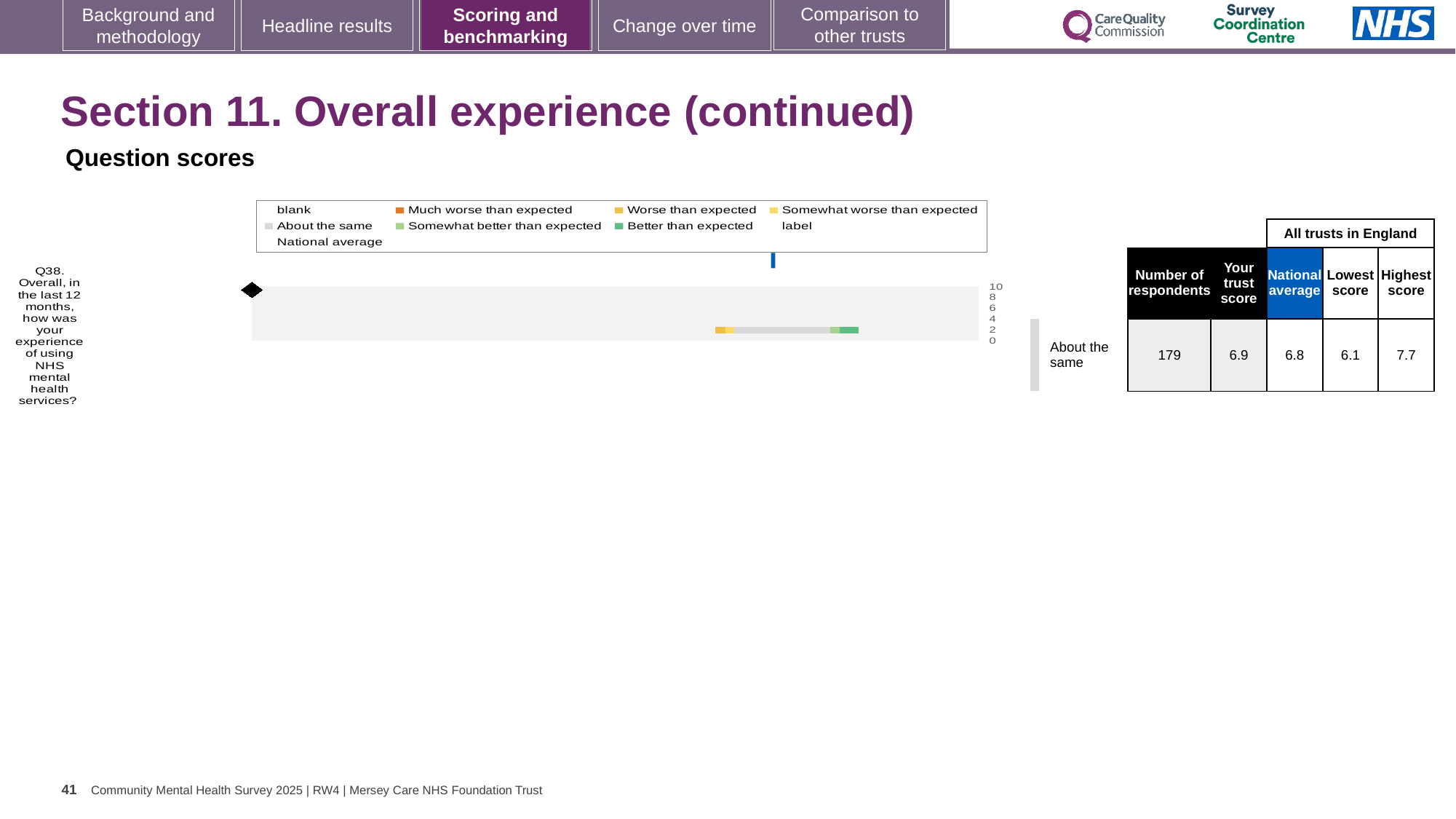
What colour does the legend use for 'Better than expected'? green Which is larger for Q38, the trust's score or the national average? the trust's score What is the difference between the highest and lowest trust scores for Q38? 1.6 What is the highest score among all trusts in England for Q38? 7.7 What is the lowest score among all trusts in England for Q38? 6.1 What is the number of respondents for Q38? 179 How many survey questions are plotted on the chart? 1 What kind of chart is used to show the Q38 question score? bar chart What is the trust's score for Q38? 6.9 What is the national average score for Q38? 6.8 Which benchmarking category is Q38 assigned to? About the same What is the highest value shown on the chart's score axis? 10